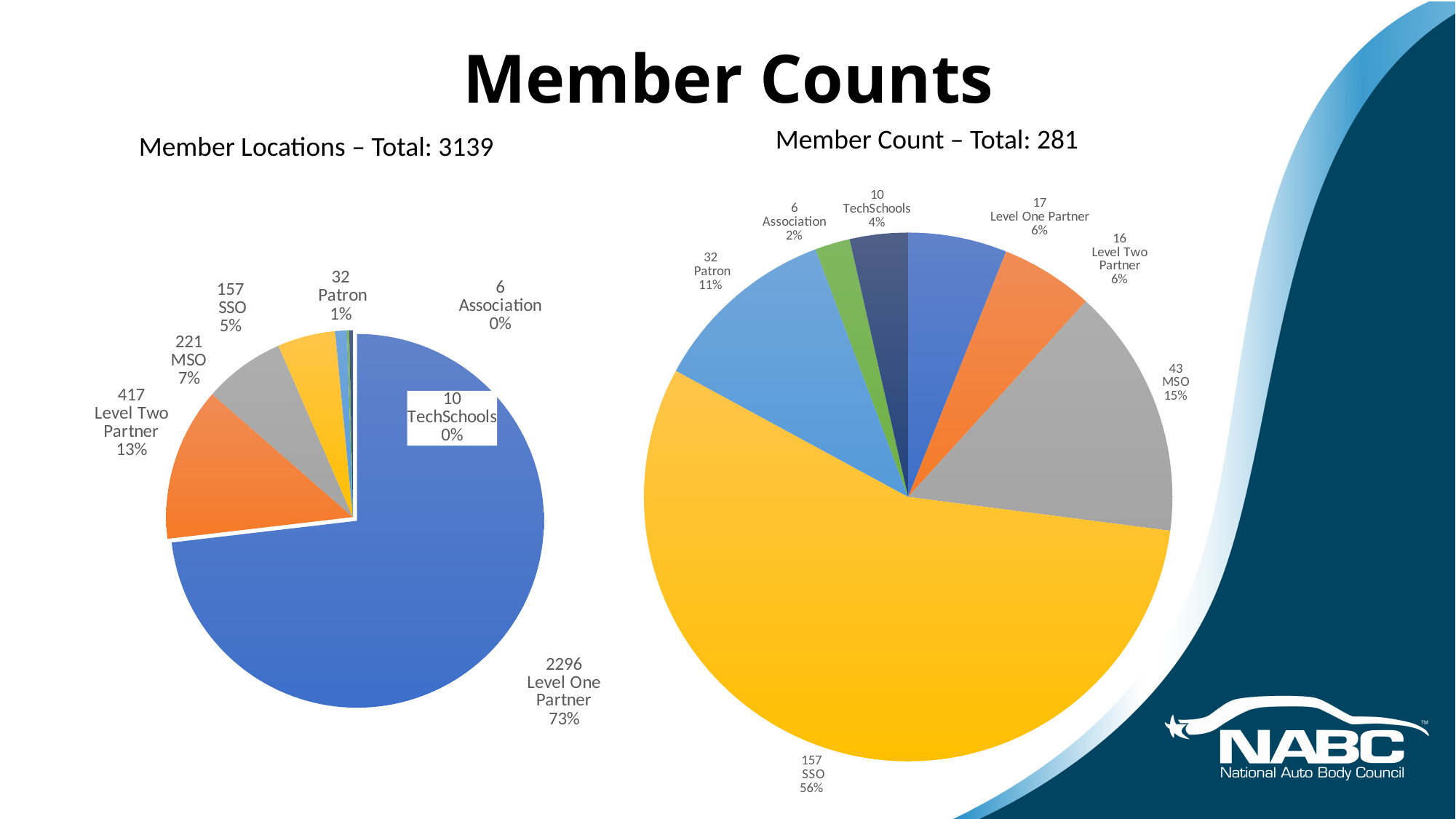
In the Member Count chart, what percentage share does MSO have? 15% How many categories does the Member Count chart show? 7 In the Member Locations chart, what is the value for Level One Partner? 2296 In the Member Locations chart, which category has the smallest value? Association What kind of chart is the Member Locations chart? Pie chart In the Member Locations chart, what percentage share does Level Two Partner have? 13% In the Member Count chart, which category has the largest slice? SSO In the Member Count chart, which is larger, Patron or Level One Partner? Patron In the Member Count chart, what is the value for SSO? 157 In the Member Locations chart, what is the difference between the MSO value and the SSO value? 64 What total is stated in the title of the chart on the right? 281 In the Member Locations chart, which category has the largest slice? Level One Partner